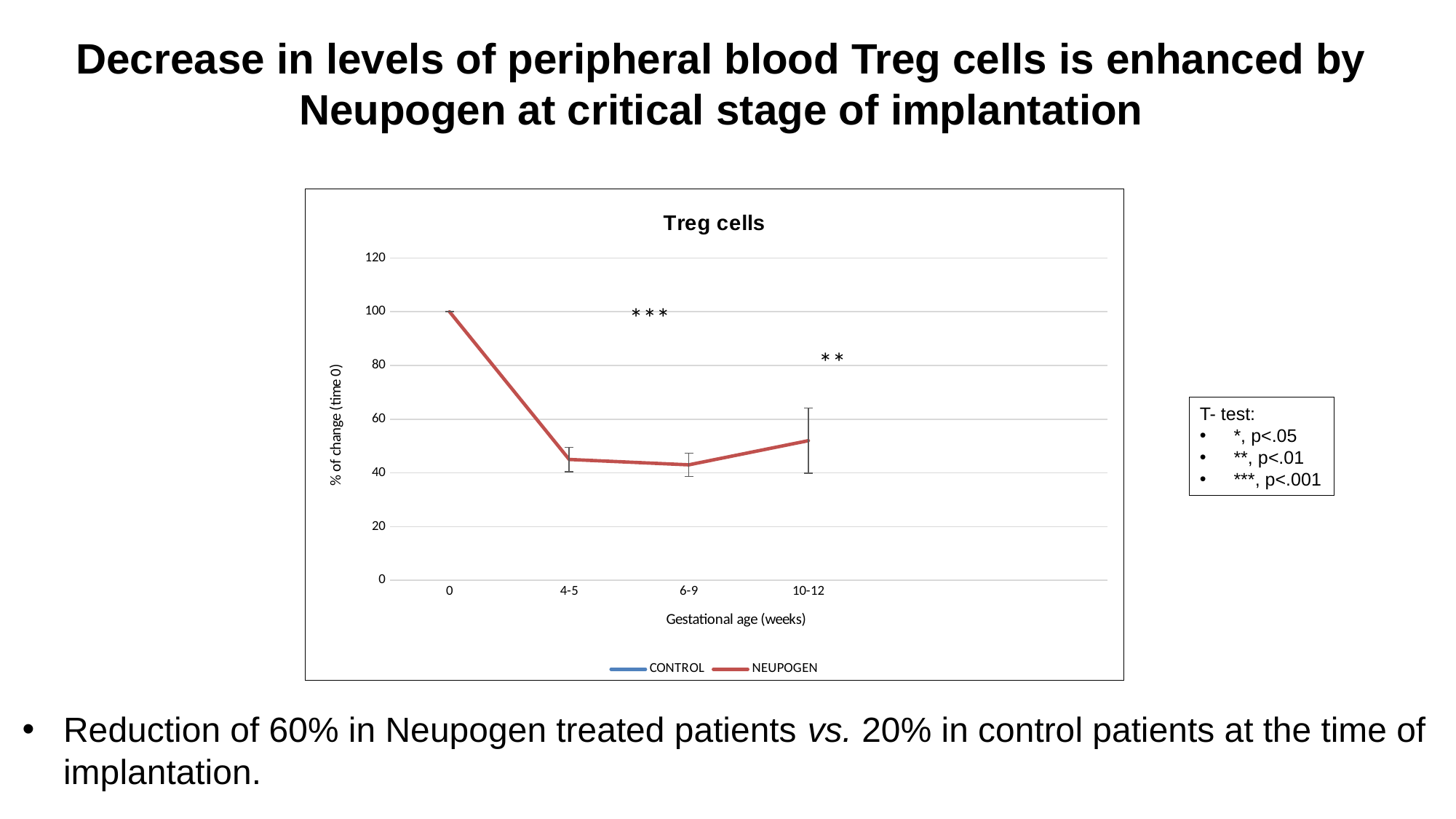
What is the title of the chart? Treg cells Is the NEUPOGEN value at 6-9 weeks greater or less than 60? less What is the label of the x axis? Gestational age (weeks) How many series does the chart legend list? 2 Is the NEUPOGEN value at 4-5 weeks greater or less than 60? less What type of chart is shown on the slide? line chart Which is larger, the NEUPOGEN value at 0 weeks or at 10-12 weeks? 0 weeks What is the NEUPOGEN value at gestational age 0 weeks? 100 At which gestational age is the NEUPOGEN value highest? 0 Is the NEUPOGEN value at 10-12 weeks greater or less than 40? greater Does the NEUPOGEN line rise or fall between 0 weeks and 4-5 weeks? fall How many gestational age categories are shown on the x axis? 4